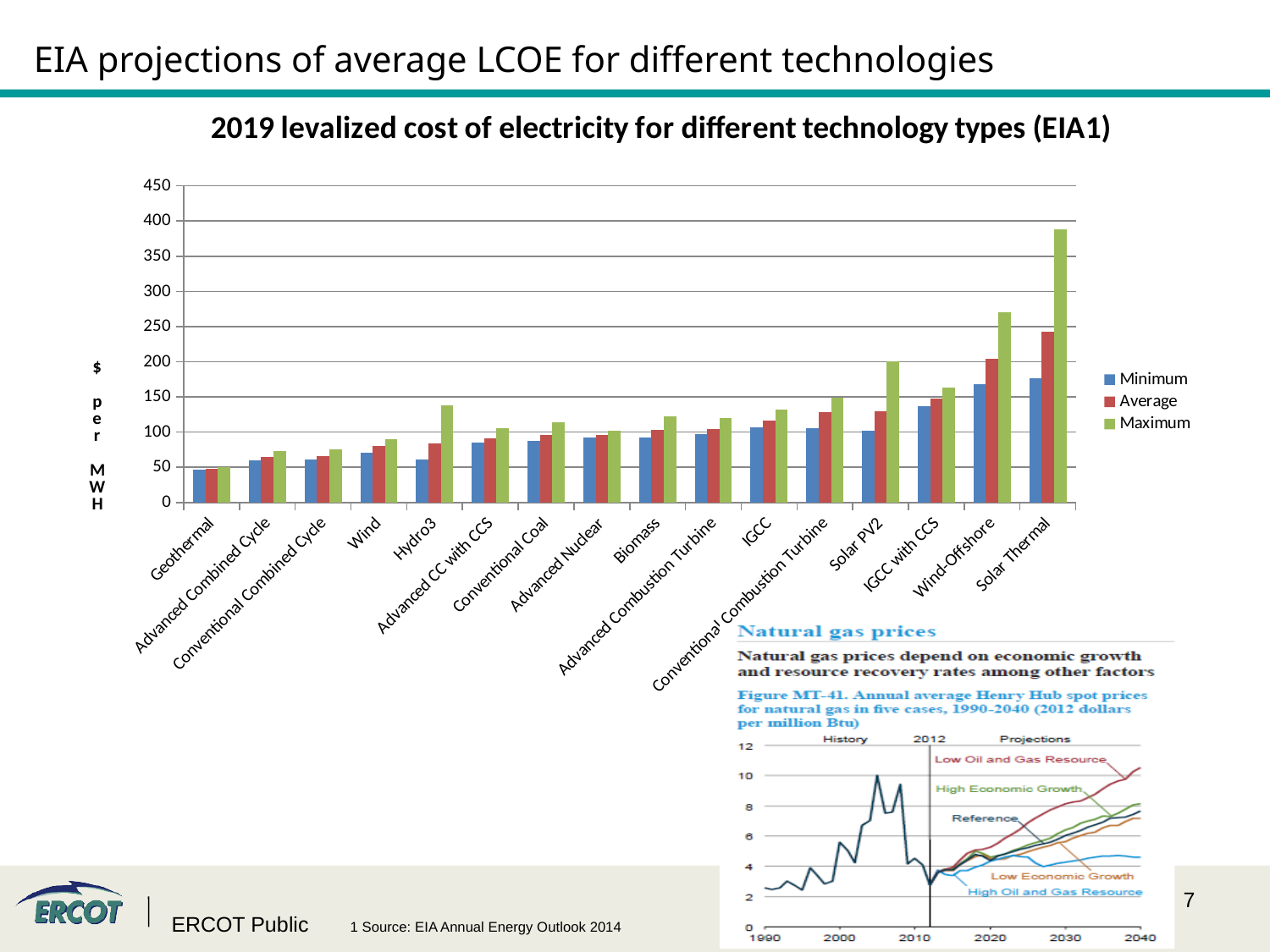
In the '2019 levalized cost of electricity for different technology types' chart, how many technology categories are shown on the x axis? 16 In the '2019 levalized cost of electricity for different technology types' chart, is the Maximum value for Solar Thermal greater or less than 350? greater In the '2019 levalized cost of electricity for different technology types' chart, do the Average values generally rise or fall from left to right along the x axis? rise In the '2019 levalized cost of electricity for different technology types' chart, is the Minimum value for Solar Thermal greater or less than 150? greater In the '2019 levalized cost of electricity for different technology types' chart, which technology has the highest Maximum value? Solar Thermal In the '2019 levalized cost of electricity for different technology types' chart, how many series does the legend list? 3 In the '2019 levalized cost of electricity for different technology types' chart, is the Maximum value for Geothermal greater or less than 100? less In the '2019 levalized cost of electricity for different technology types' chart, which is larger, the Average value for Solar Thermal or the Average value for Wind-Offshore? Solar Thermal In the '2019 levalized cost of electricity for different technology types' chart, which technology has the lowest Minimum value? Geothermal In the '2019 levalized cost of electricity for different technology types' chart, which legend entry is shown in green? Maximum In the '2019 levalized cost of electricity for different technology types' chart, what kind of chart is it? bar chart